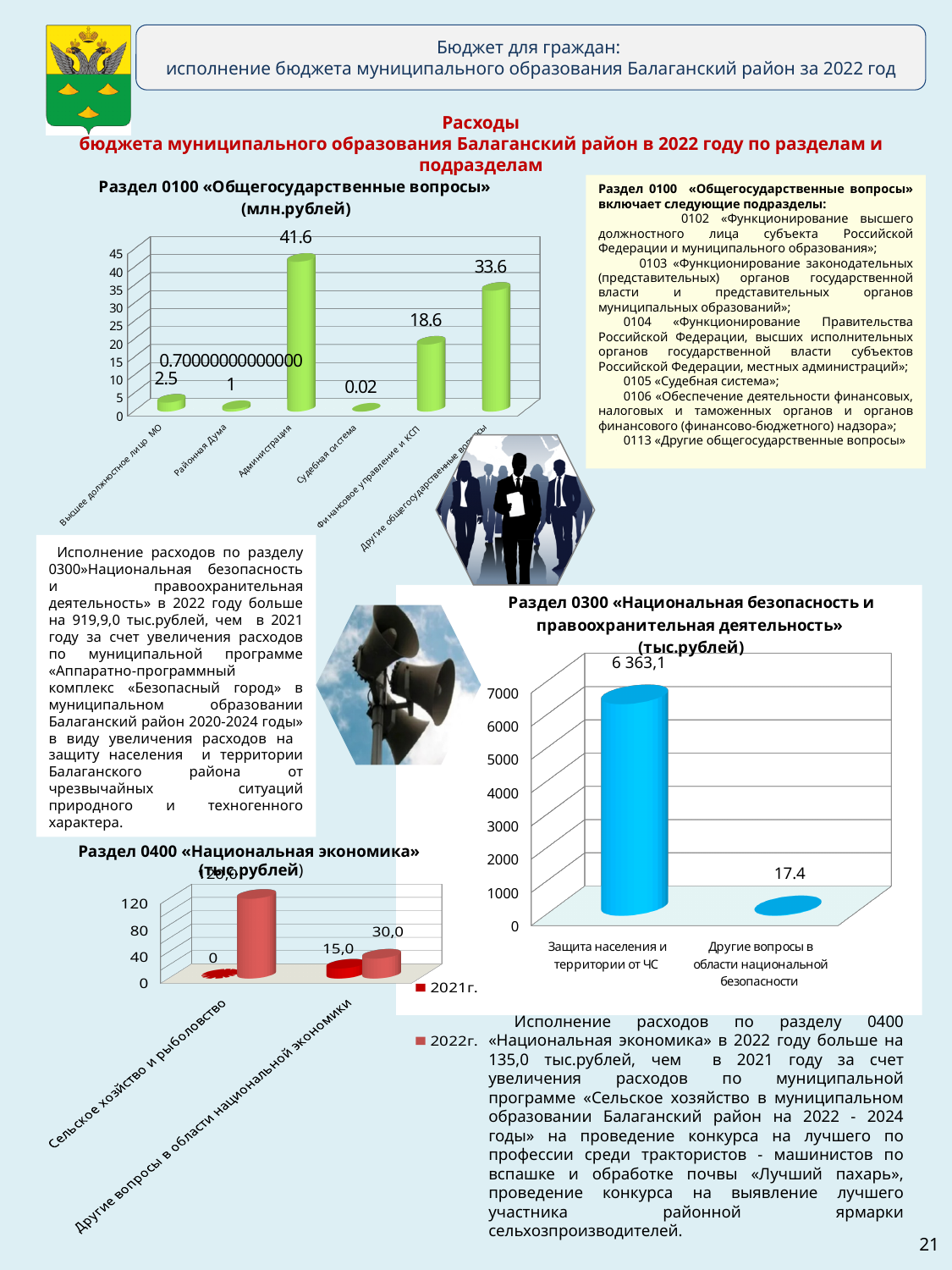
In the chart 'Раздел 0100 «Общегосударственные вопросы»', which category has the lowest value? Судебная система In the chart 'Раздел 0400 «Национальная экономика»', what is the 2022г. value for Другие вопросы в области национальной экономики? 30,0 In the chart 'Раздел 0300 «Национальная безопасность и правоохранительная деятельность»', what is the value for Защита населения и территории от ЧС? 6 363,1 In the chart 'Раздел 0300 «Национальная безопасность и правоохранительная деятельность»', what is the value for Другие вопросы в области национальной безопасности? 17.4 In the chart 'Раздел 0100 «Общегосударственные вопросы»', what is the value for Финансовое управление и КСП? 18.6 How many categories are shown in the chart 'Раздел 0100 «Общегосударственные вопросы»'? 6 In the chart 'Раздел 0400 «Национальная экономика»', which is larger for Другие вопросы в области национальной экономики: 2021г. or 2022г.? 2022г. In the chart 'Раздел 0100 «Общегосударственные вопросы»', what is the value for Администрация? 41.6 In the chart 'Раздел 0100 «Общегосударственные вопросы»', which category has the highest value? Администрация How many series does the legend list in the chart 'Раздел 0400 «Национальная экономика»'? 2 In the chart 'Раздел 0100 «Общегосударственные вопросы»', what is the difference between Администрация and Другие общегосударственные вопросы? 8 In the chart 'Раздел 0300 «Национальная безопасность и правоохранительная деятельность»', is the value for Защита населения и территории от ЧС greater or less than 6000? greater